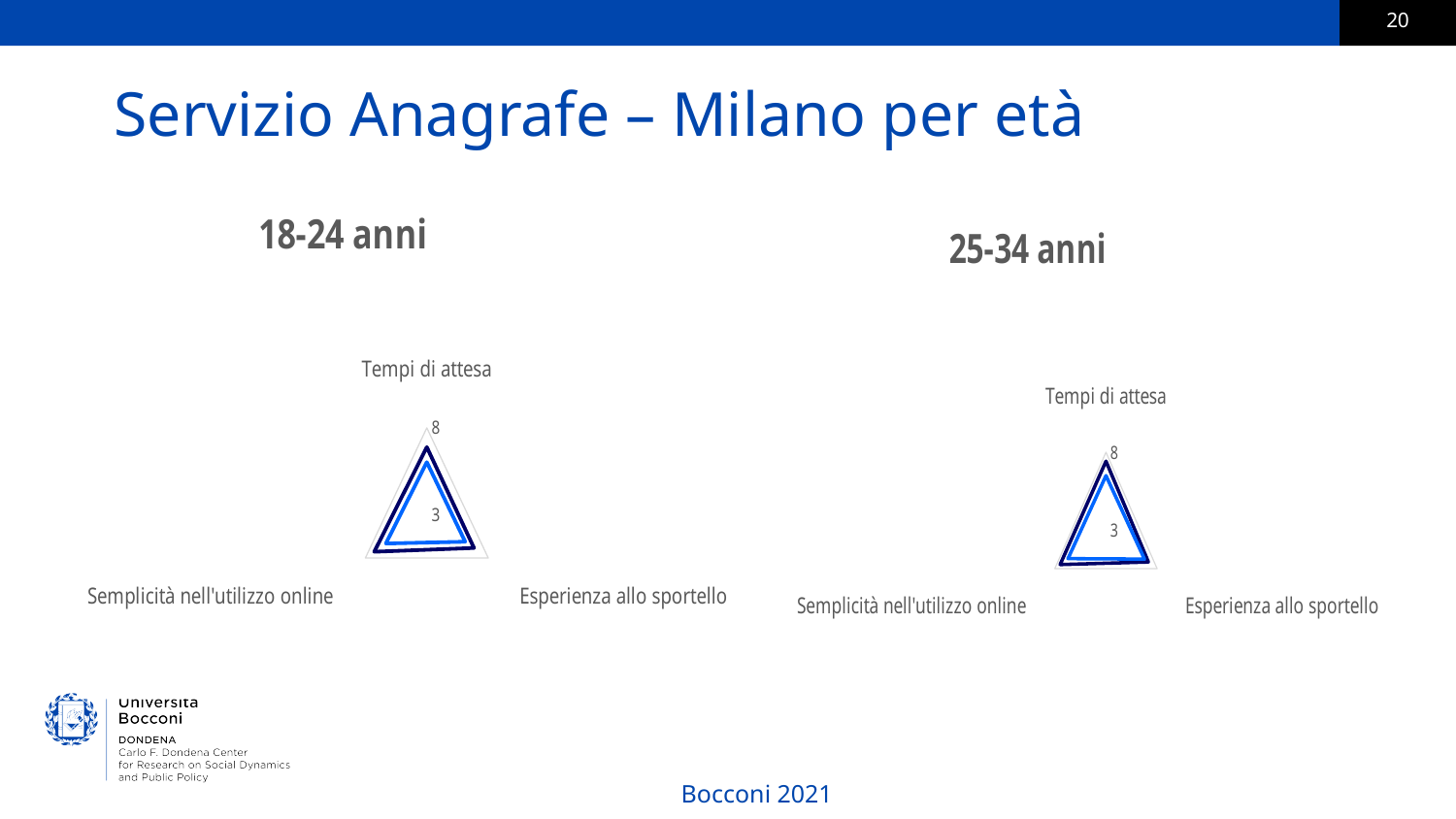
What kind of chart is used for the 18-24 anni group? radar chart What kind of chart is used for the 25-34 anni group? radar chart Which category label appears at the top axis of the 25-34 anni chart? Tempi di attesa In the 18-24 anni chart, is the value for Esperienza allo sportello greater or less than 3? greater In the 25-34 anni chart, is the value for Semplicità nell'utilizzo online greater or less than 3? greater In the 18-24 anni chart, is the value for Tempi di attesa greater or less than 3? greater What is the title of the chart on the left side of the slide? 18-24 anni How many categories (axes) does the 25-34 anni chart have? 3 How many categories (axes) does the 18-24 anni chart have? 3